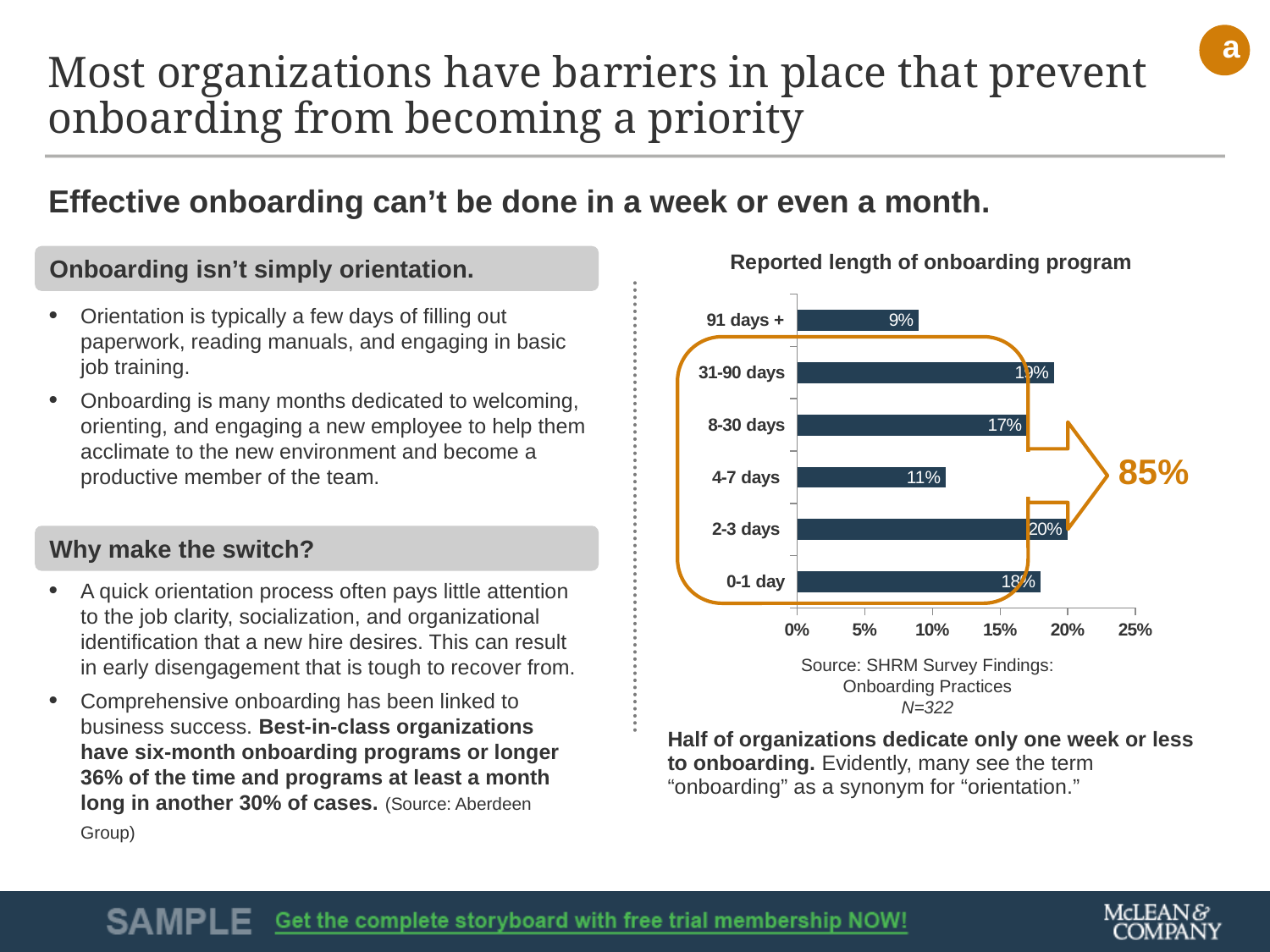
What is the title of the chart? Reported length of onboarding program What kind of chart is shown on the slide? Bar chart Which category has the lowest value in the chart? 91 days + What is the difference between the values for 8-30 days and 4-7 days? 6 percentage points What is the value for the 2-3 days category? 20% What is the value for the 91 days + category in the Reported length of onboarding program chart? 9% Is the value for 0-1 day greater or less than 15%? greater How many categories are shown in the chart? 6 Which is larger, the value for 8-30 days or the value for 4-7 days? 8-30 days Is the value for 31-90 days greater or less than 15%? greater What is the value for the 8-30 days category? 17% What is the value for the 4-7 days category? 11%